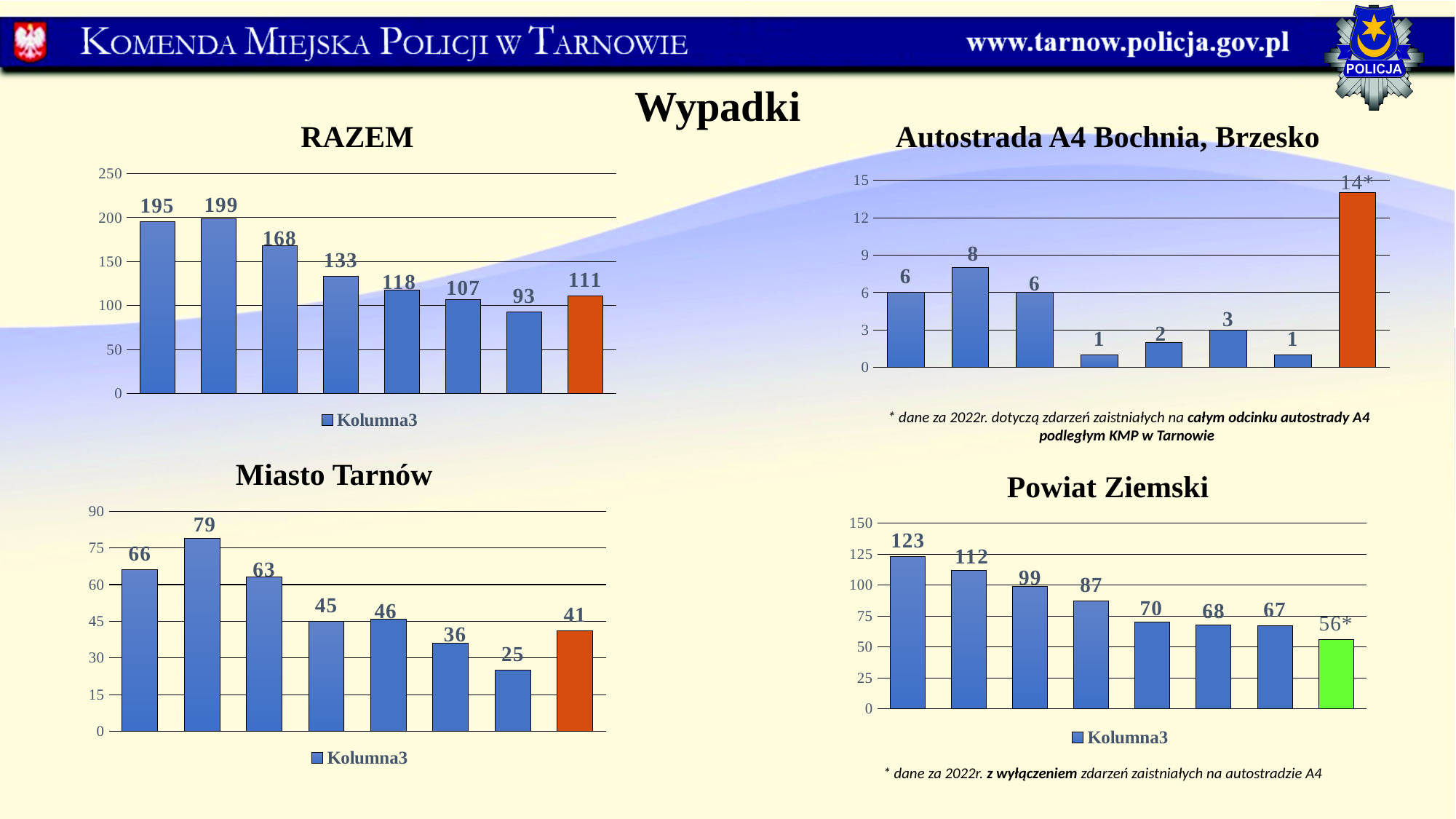
In the Miasto Tarnów chart, which is larger, the fourth bar or the fifth bar? The fifth bar (46) In the Powiat Ziemski chart, what is the value of the last (green) bar? 56* In the Miasto Tarnów chart, what is the value of the second bar? 79 In the RAZEM chart, what is the difference between the first bar (195) and the last bar (111)? 84 In the Powiat Ziemski chart, do the values generally rise or fall from left to right? Fall In the RAZEM chart, what is the value of the last (orange) bar? 111 In the RAZEM chart, which bar has the highest value? The second bar (199) In the Autostrada A4 Bochnia, Brzesko chart, what is the lowest value shown? 1 In the RAZEM chart, what is the value of the first bar? 195 How many bars are in the Miasto Tarnów chart? 8 What type of chart is the Powiat Ziemski chart? Bar chart In the Autostrada A4 Bochnia, Brzesko chart, what is the value of the last (orange) bar? 14*